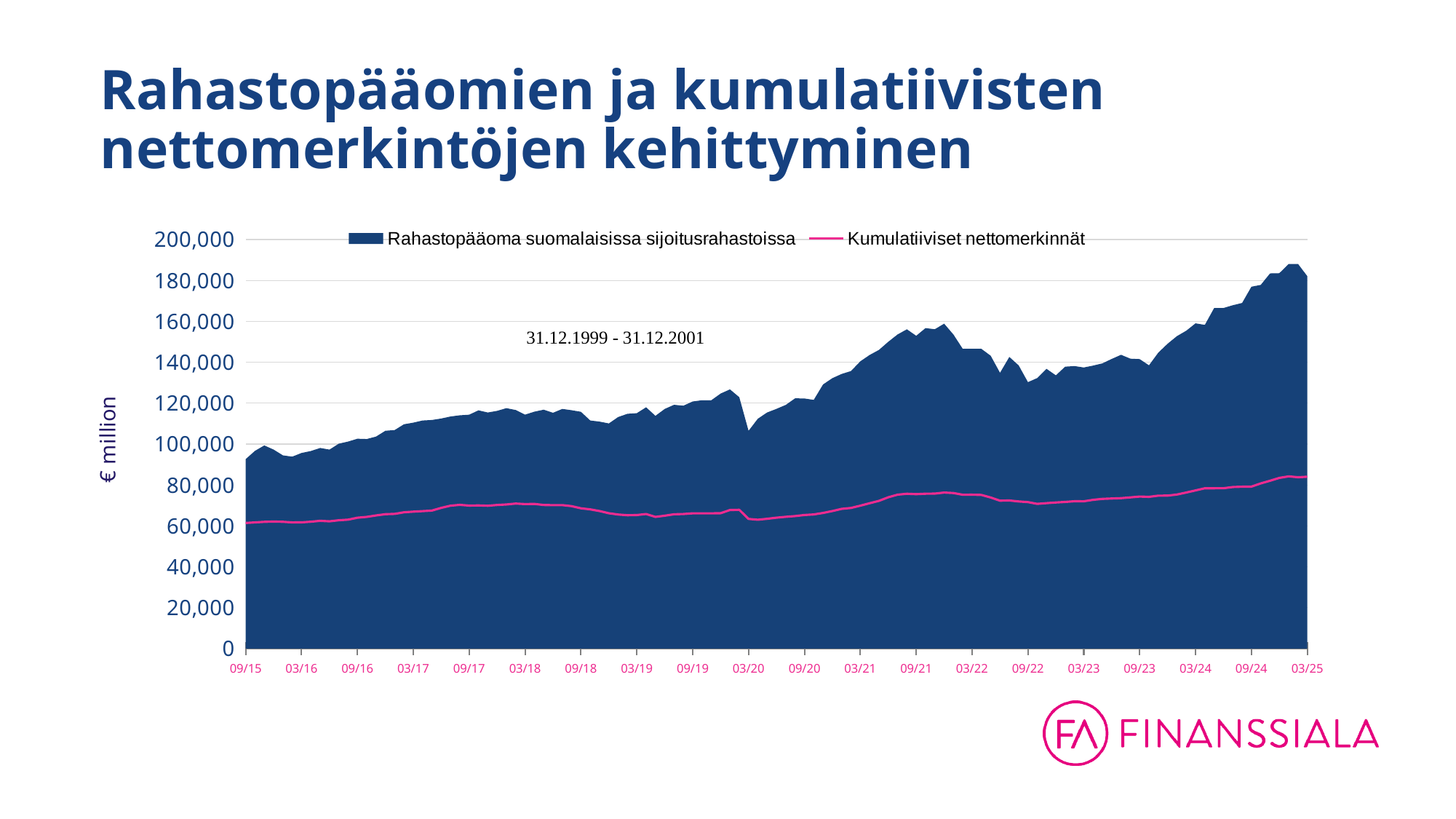
Is the value of Kumulatiiviset nettomerkinnät at 09/21 greater or less than 80,000? less Overall, does Rahastopääoma suomalaisissa sijoitusrahastoissa rise or fall from 09/15 to 03/25? rise Is the value of Rahastopääoma suomalaisissa sijoitusrahastoissa at 09/21 greater or less than 140,000? greater What is the label of the y axis? € million Which series has the higher value at 03/25, Rahastopääoma suomalaisissa sijoitusrahastoissa or Kumulatiiviset nettomerkinnät? Rahastopääoma suomalaisissa sijoitusrahastoissa How many date labels are shown on the x axis? 20 Is the value of Rahastopääoma suomalaisissa sijoitusrahastoissa at 03/25 greater or less than 160,000? greater Which series is drawn as a pink line? Kumulatiiviset nettomerkinnät What kind of chart is shown on the slide? combination area and line chart How many series does the legend list? 2